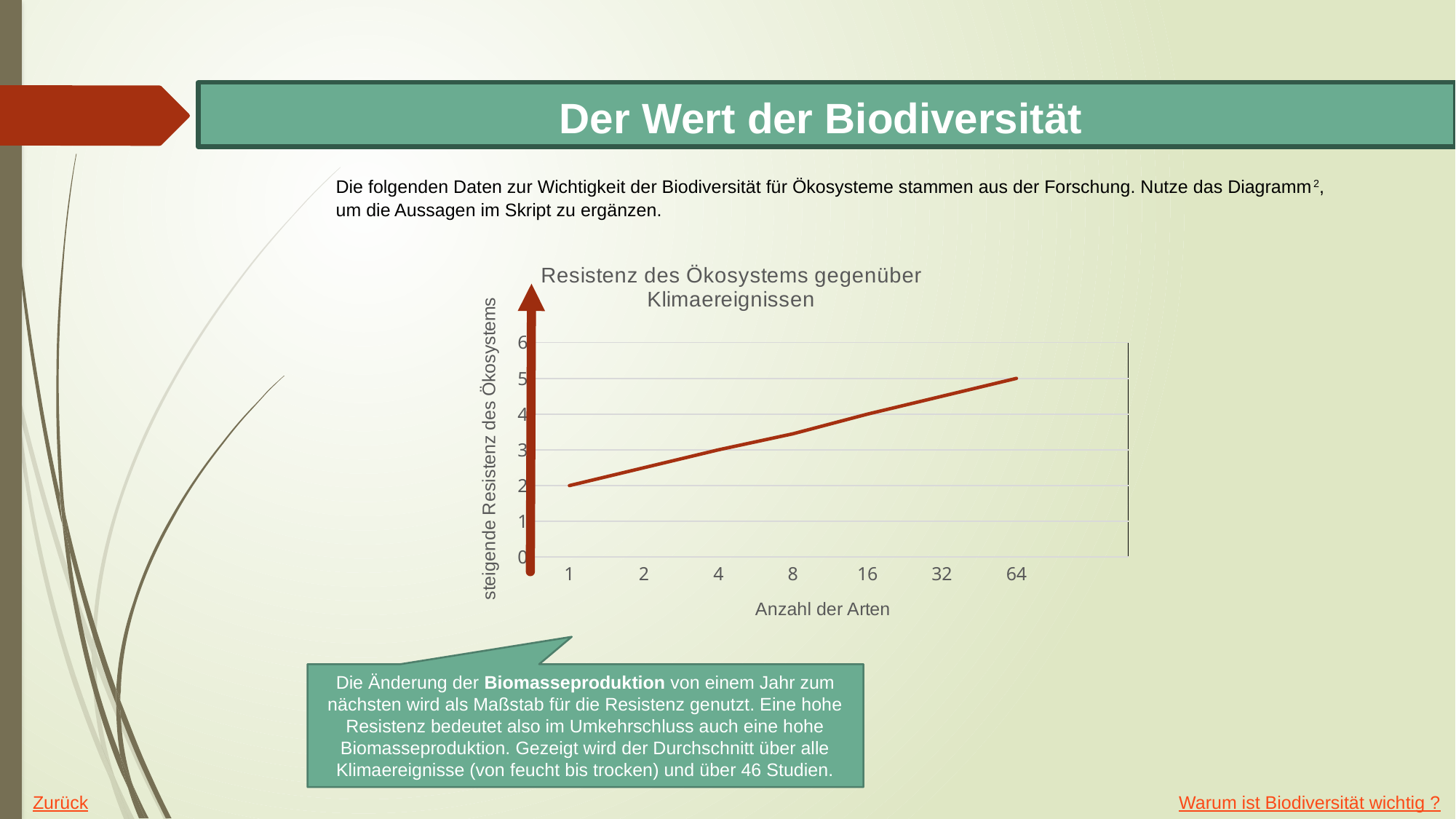
Which category on the x axis has the highest value? 64 Do the values rise or fall as the number of species (Anzahl der Arten) increases along the x axis? rise What kind of chart is shown on the slide? line chart Is the value for 8 species greater or less than 3? greater What is the value plotted for 64 species (Anzahl der Arten = 64)? 5 How many categories are shown on the x axis of the chart? 7 Is the value for 2 species greater or less than 3? less What is the difference between the value for 64 species and the value for 1 species? 3 Which category on the x axis has the lowest value? 1 What is the label of the x axis of the chart? Anzahl der Arten What is the value plotted for 1 species (Anzahl der Arten = 1)? 2 What is the title of the chart? Resistenz des Ökosystems gegenüber Klimaereignissen